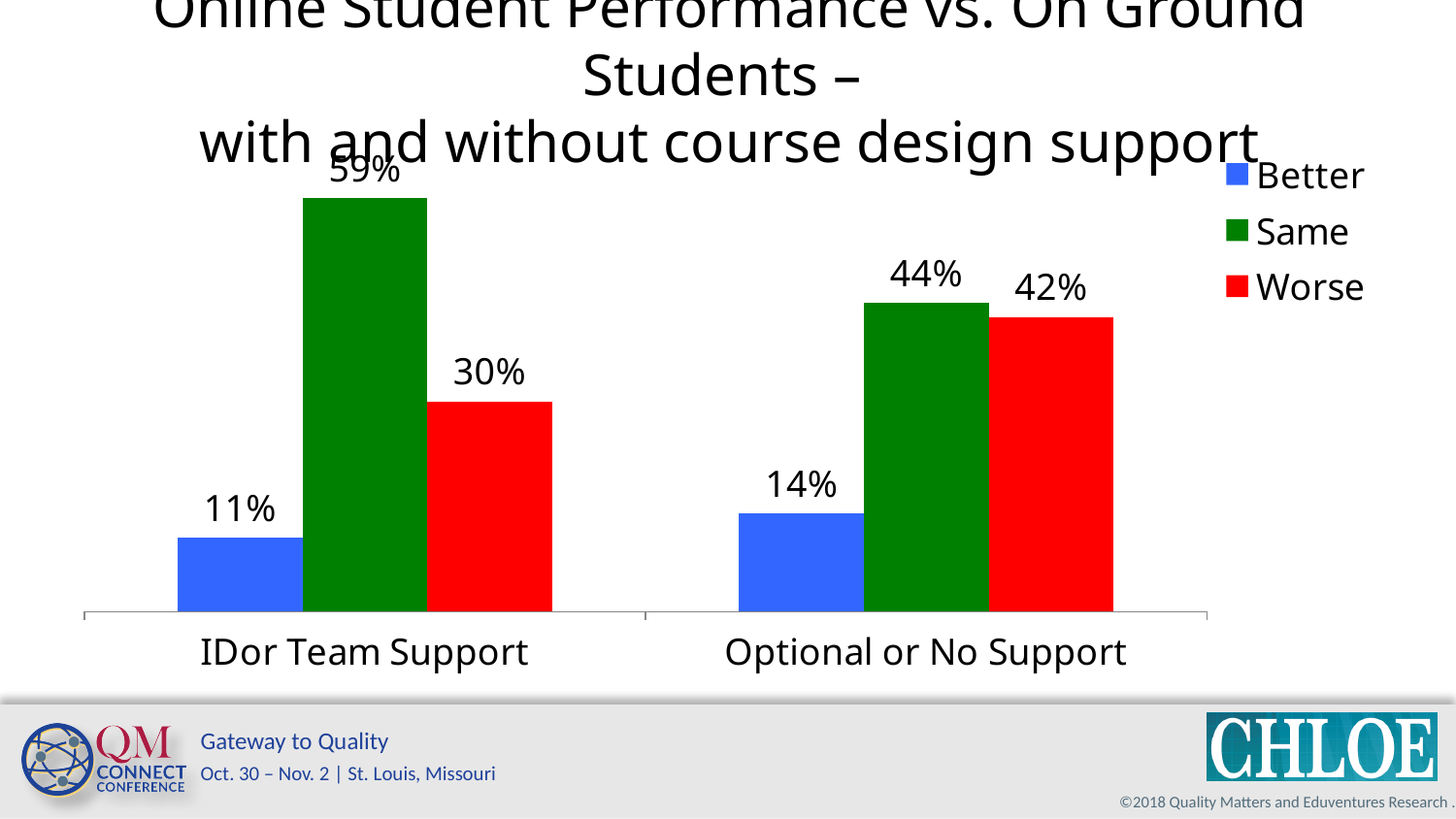
What is the value for Better under Optional or No Support? 14% Which series has the highest value under IDor Team Support? Same What is the difference between the Same values for IDor Team Support and Optional or No Support? 15% What kind of chart is shown on the slide? Bar chart What is the value for Worse under IDor Team Support? 30% What is the value for Worse under Optional or No Support? 42% Which is larger: the Worse value for IDor Team Support or the Worse value for Optional or No Support? Optional or No Support What is the value for Same under IDor Team Support? 59% Which series has the lowest value under Optional or No Support? Better How many categories are shown on the x axis? 2 What colour represents the Worse series in the legend? Red How many series does the legend list? 3